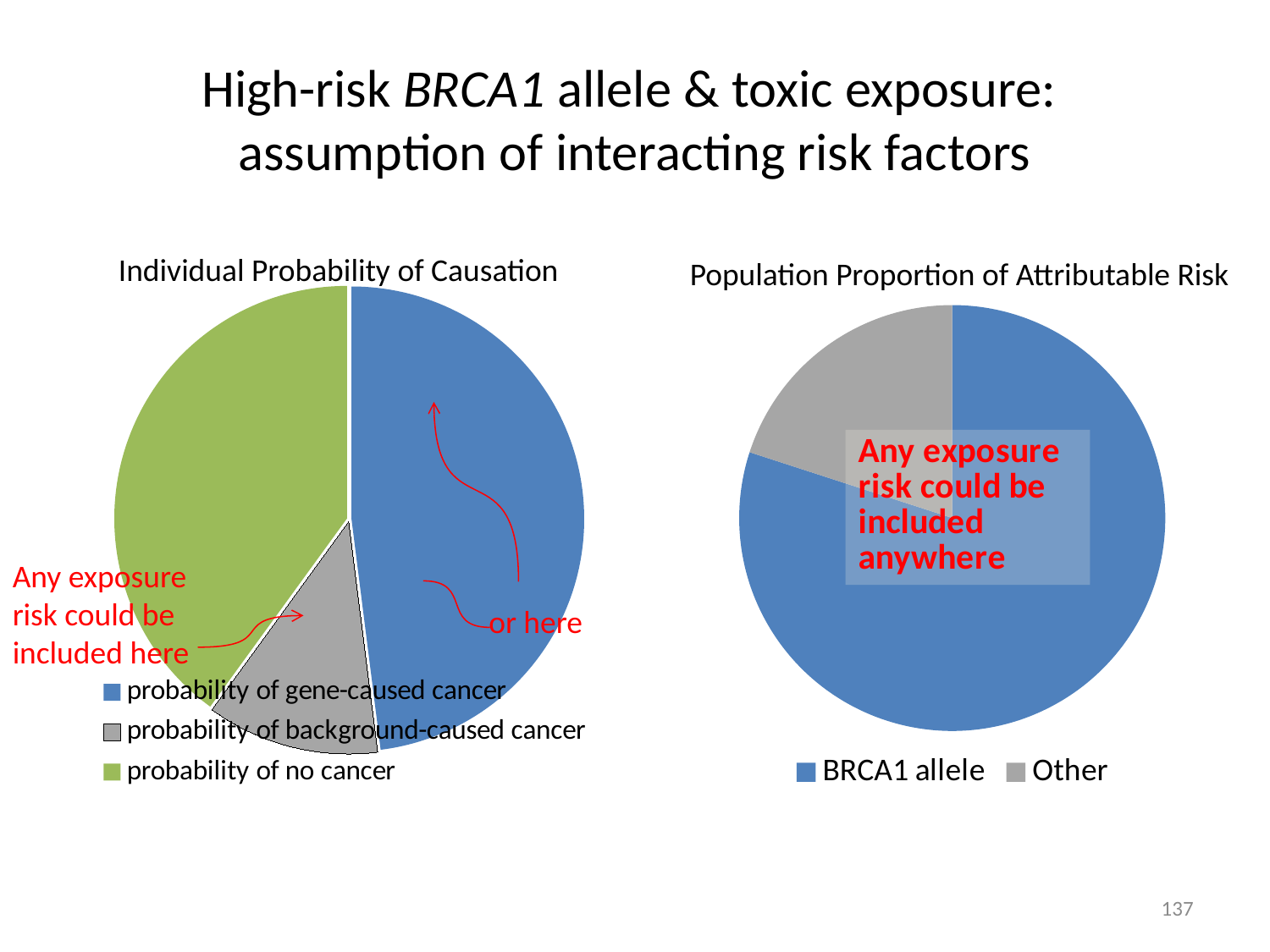
How many entries does the legend of the 'Individual Probability of Causation' chart list? 3 In the 'Population Proportion of Attributable Risk' chart, which slice is larger: 'BRCA1 allele' or 'Other'? BRCA1 allele How many entries does the legend of the 'Population Proportion of Attributable Risk' chart list? 2 In the 'Individual Probability of Causation' chart, which category has the smallest slice? probability of background-caused cancer In the 'Individual Probability of Causation' chart, which category has the largest slice? probability of gene-caused cancer What kind of chart is the 'Population Proportion of Attributable Risk' chart? pie chart What kind of chart is the 'Individual Probability of Causation' chart? pie chart What colour is the 'Other' slice in the 'Population Proportion of Attributable Risk' chart? gray How many slices does the 'Population Proportion of Attributable Risk' pie chart have? 2 How many slices does the 'Individual Probability of Causation' pie chart have? 3 In the 'Individual Probability of Causation' chart, which slice is larger: 'probability of no cancer' or 'probability of background-caused cancer'? probability of no cancer In the 'Population Proportion of Attributable Risk' chart, which category has the largest slice? BRCA1 allele